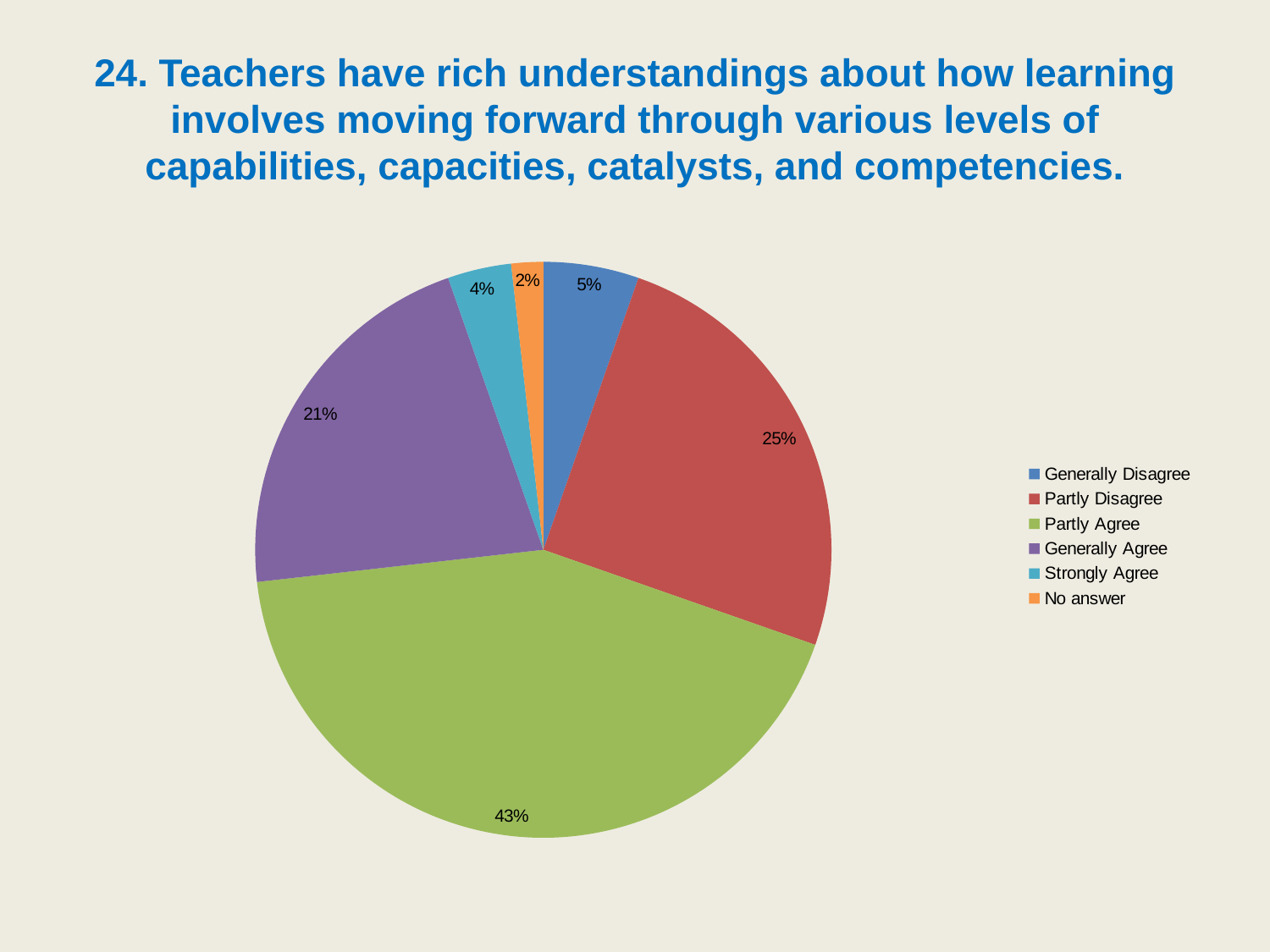
What colour is the Partly Agree slice? green Which response category has the largest share of the pie? Partly Agree What kind of chart is shown on the slide? pie chart Which is larger, the share for Generally Disagree or the share for Strongly Agree? Generally Disagree What percentage of respondents chose Strongly Agree? 4% What percentage of respondents chose Generally Agree? 21% What percentage of respondents chose Partly Disagree? 25% What percentage of respondents chose Partly Agree? 43% How many categories does the legend list? 6 What percentage of respondents gave No answer? 2% What is the difference in percentage points between Partly Agree and Partly Disagree? 18 Which response category has the smallest share of the pie? No answer